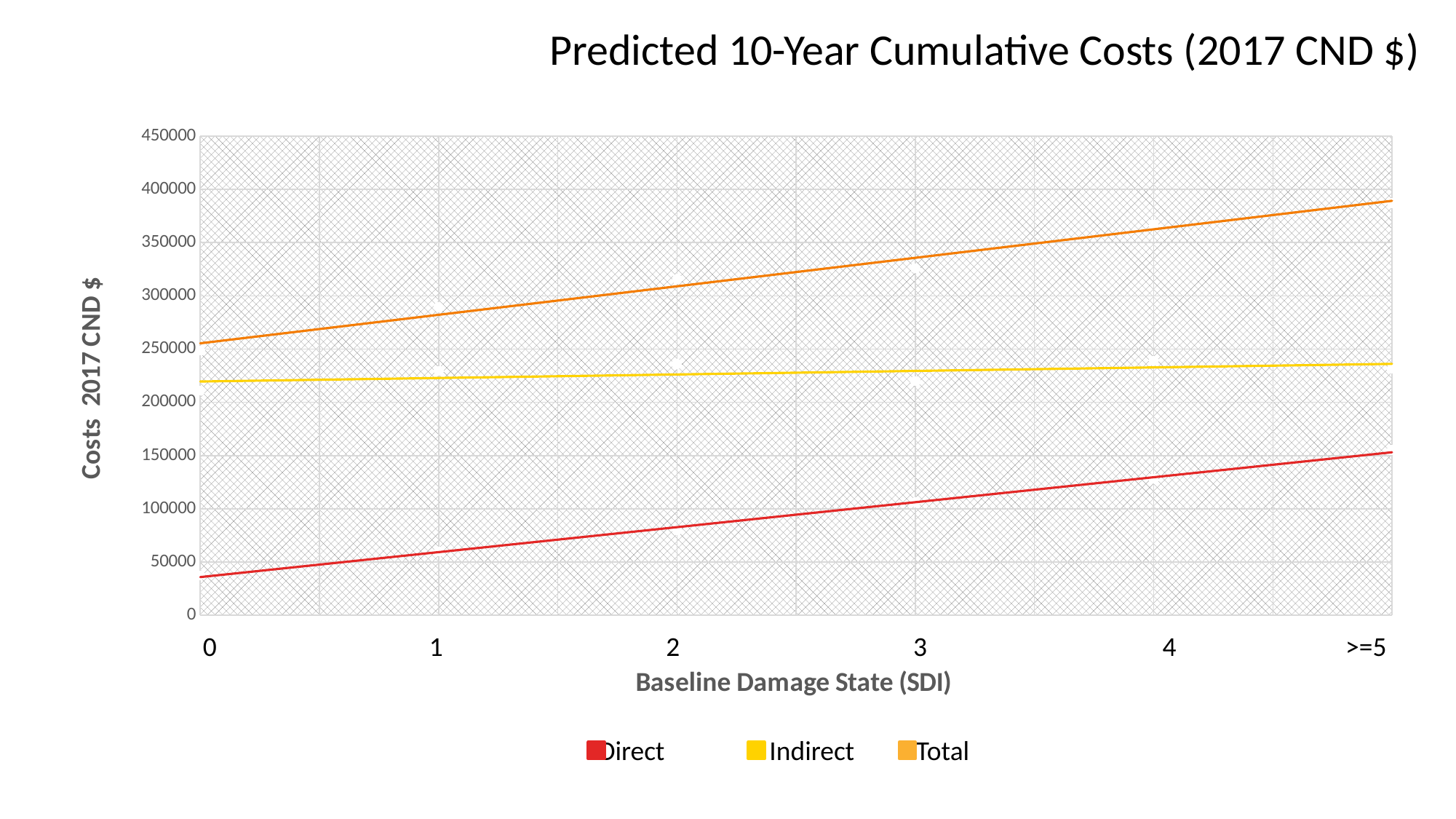
What kind of chart is shown on the slide? line chart Which series has the highest value at baseline damage state >=5? Total How many categories are shown on the x axis? 6 What is the title of the chart? Predicted 10-Year Cumulative Costs (2017 CND $) Is the value for Direct at baseline damage state 2 greater or less than 100000? less Do the values of the Direct series rise or fall as the baseline damage state increases? rise Is the value for Total at baseline damage state >=5 greater or less than 400000? less Do the values of the Total series rise or fall as the baseline damage state increases? rise Is the value for Direct at baseline damage state 0 greater or less than 50000? less How many series does the legend list? 3 What is the label of the x axis? Baseline Damage State (SDI)